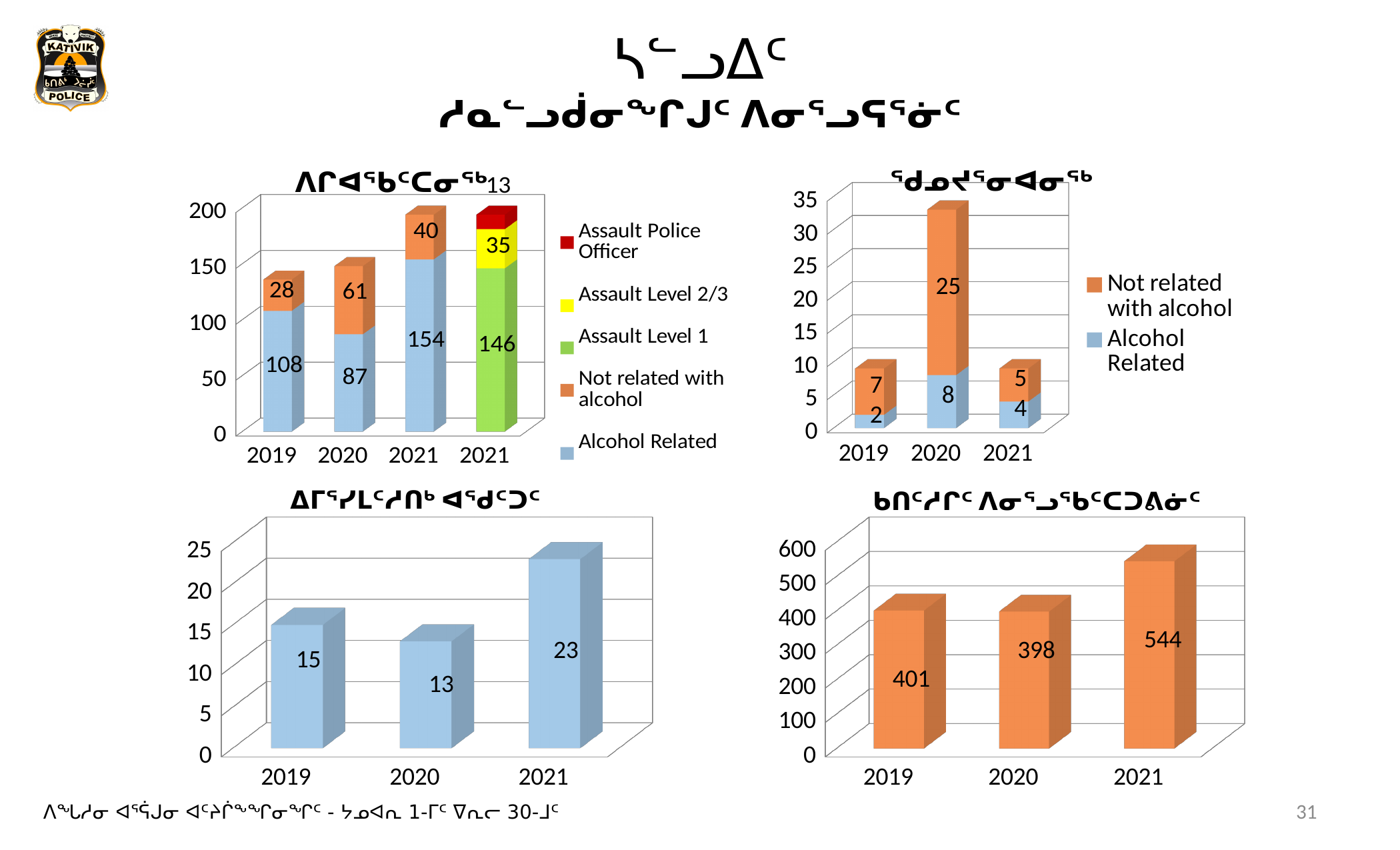
In the top-right chart, how many series does the legend list? 2 In the top-left chart, what is the 'Alcohol Related' value for 2020? 87 In the bottom-right chart, what is the difference between the 2021 and 2019 values? 143 In the bottom-left chart, what is the value for 2020? 13 In the bottom-right chart, which year has the lowest value? 2020 In the top-right chart, what is the 'Not related with alcohol' value for 2020? 25 In the top-left chart, what is the 'Assault Level 2/3' value shown on the second 2021 bar? 35 In the bottom-right chart, what is the value for 2021? 544 In the top-right chart, what is the total of the stacked bar for 2019? 9 In the bottom-left chart, which year has the highest value? 2021 In the top-left chart, how many series does the legend list? 5 In the bottom-left chart, how many bars are plotted? 3